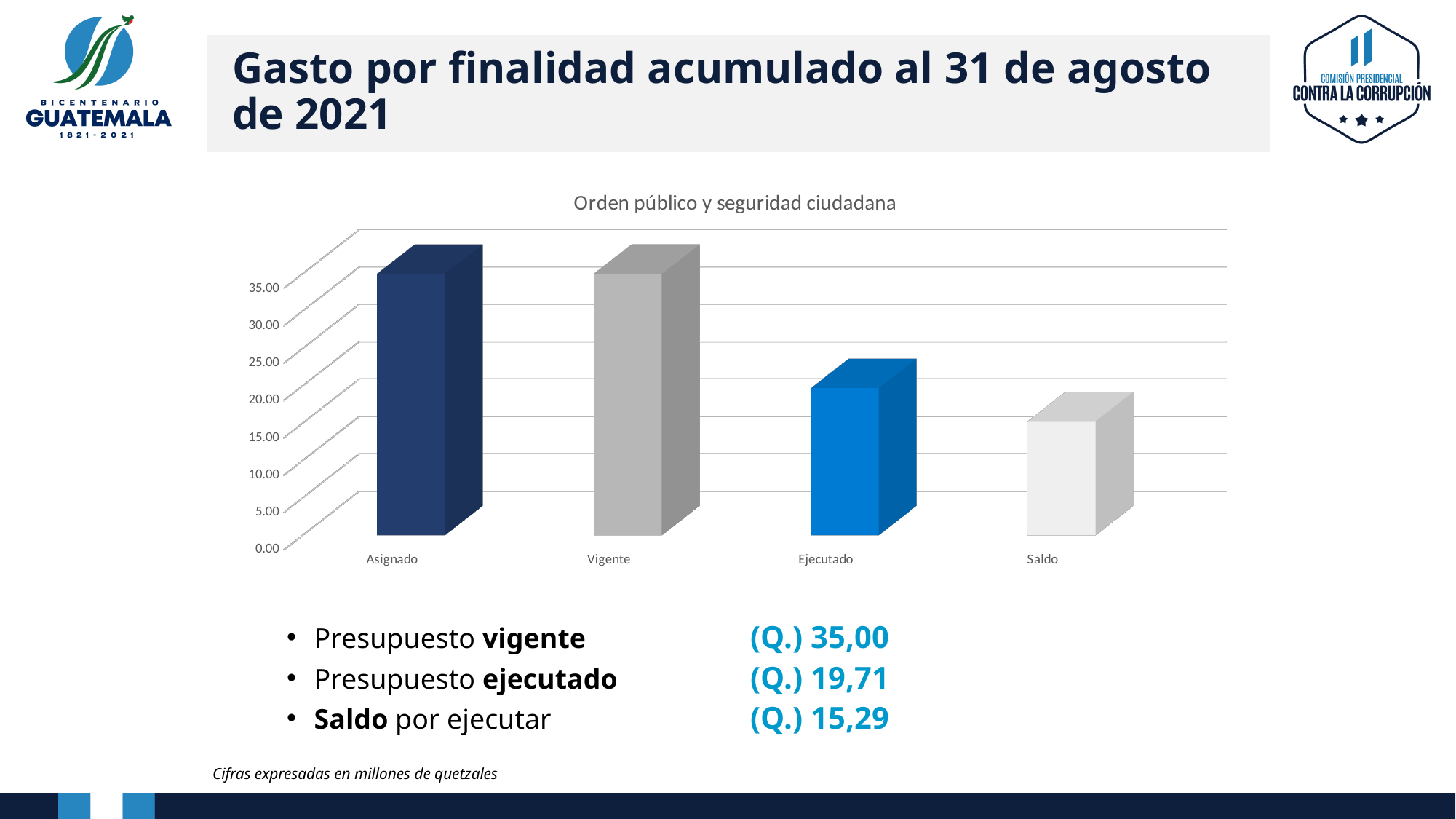
What is the title of the chart? Orden público y seguridad ciudadana Is the value for Ejecutado greater or less than 25.00? less According to the slide, what is the value of the presupuesto ejecutado? (Q.) 19,71 Is the value for Saldo greater or less than 20.00? less How many categories are plotted in the chart? 4 In what units are the figures on the slide expressed? millones de quetzales Which is larger, the value for Ejecutado or the value for Saldo? Ejecutado According to the slide, what is the value of the presupuesto vigente? (Q.) 35,00 Which is larger, the value for Vigente or the value for Ejecutado? Vigente Is the value for Asignado greater or less than 30.00? greater What kind of chart is shown on the slide? bar chart Which category has the lowest value in the chart? Saldo